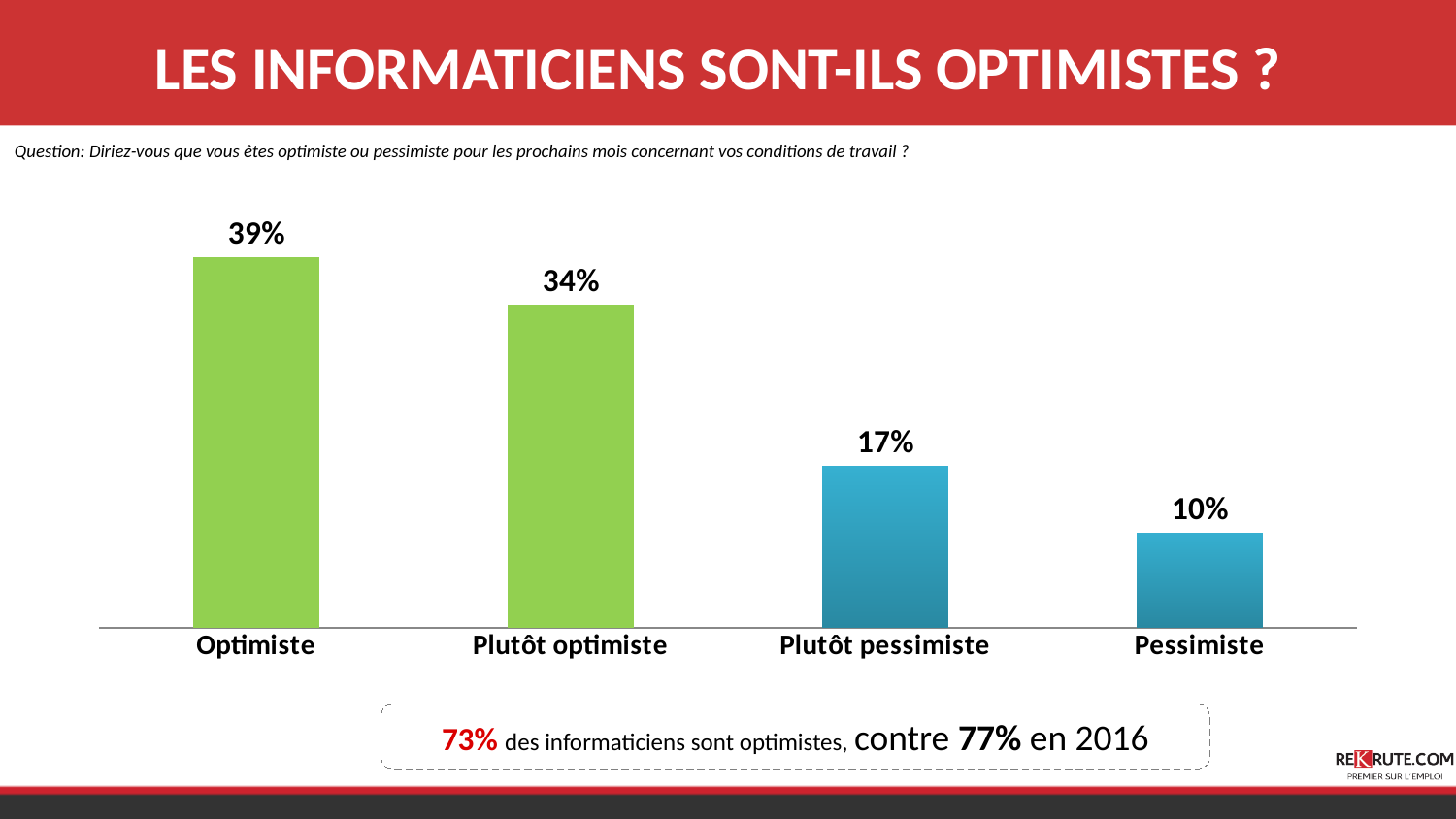
What kind of chart is shown on the slide? Bar chart How many categories are shown in the chart? 4 What is the difference between the values for Plutôt pessimiste and Pessimiste? 7% Which category has the highest value? Optimiste Which is larger, the value for Plutôt optimiste or the value for Plutôt pessimiste? Plutôt optimiste What is the value for Optimiste? 39% What is the difference between the values for Optimiste and Plutôt optimiste? 5% What is the value for Pessimiste? 10% What is the value for Plutôt pessimiste? 17% Do the values rise or fall from left to right along the x axis? Fall What is the value for Plutôt optimiste? 34% Which category has the lowest value? Pessimiste